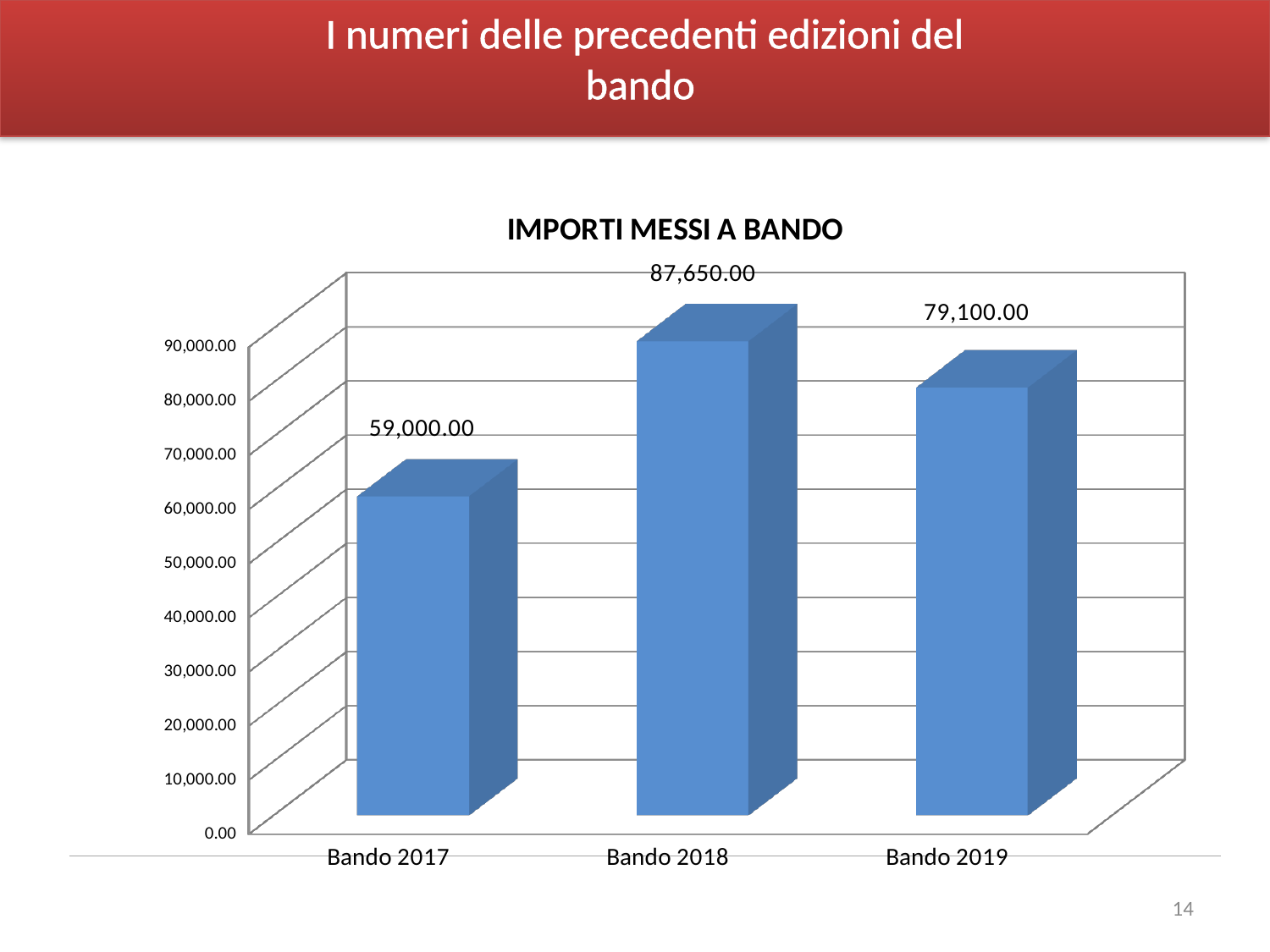
What kind of chart is shown on the slide? bar chart How many categories are shown on the chart? 3 What is the difference between the values for Bando 2018 and Bando 2019? 8,550.00 Which category has the lowest value? Bando 2017 Is the value for Bando 2017 greater or less than 70,000.00? less What is the value for Bando 2019? 79,100.00 What is the difference between the values for Bando 2019 and Bando 2017? 20,100.00 What is the value for Bando 2017? 59,000.00 What is the title of the chart? IMPORTI MESSI A BANDO Which is larger, the value for Bando 2017 or the value for Bando 2019? Bando 2019 Which category has the highest value? Bando 2018 What is the value for Bando 2018? 87,650.00